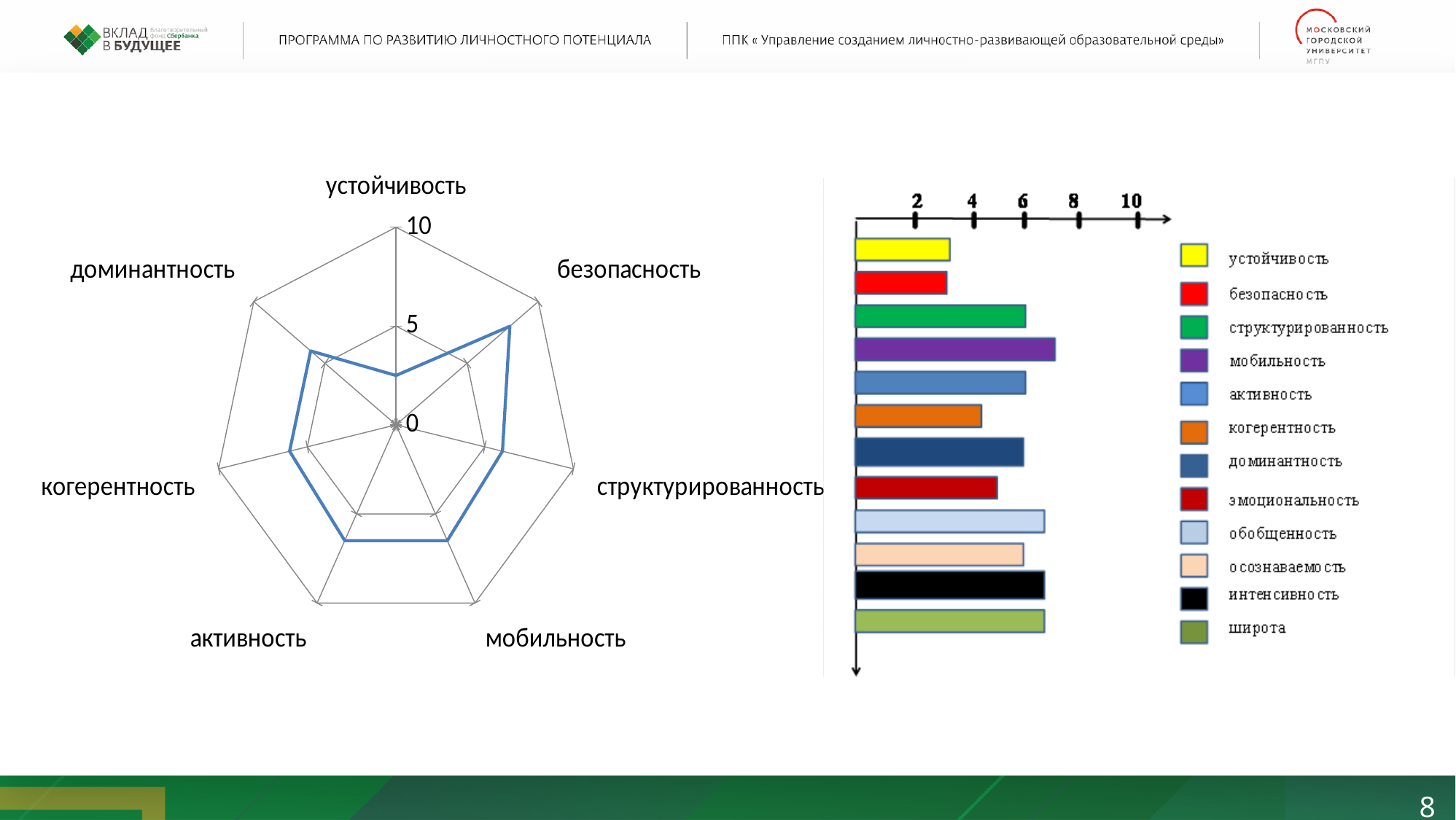
In the bar chart on the right, is the value for мобильность greater or less than 6? greater In the radar chart on the left, which is larger, the value for безопасность or the value for устойчивость? безопасность In the bar chart on the right, which is larger, the value for мобильность or the value for безопасность? мобильность In the bar chart on the right, is the value for безопасность greater or less than 4? less In the bar chart on the right, is the value for эмоциональность greater or less than 6? less What kind of chart is the chart on the left side of the slide? radar chart How many bars are plotted in the bar chart on the right? 12 What kind of chart is the chart on the right side of the slide? bar chart How many entries does the legend of the bar chart on the right list? 12 How many categories (axes) does the radar chart on the left have? 7